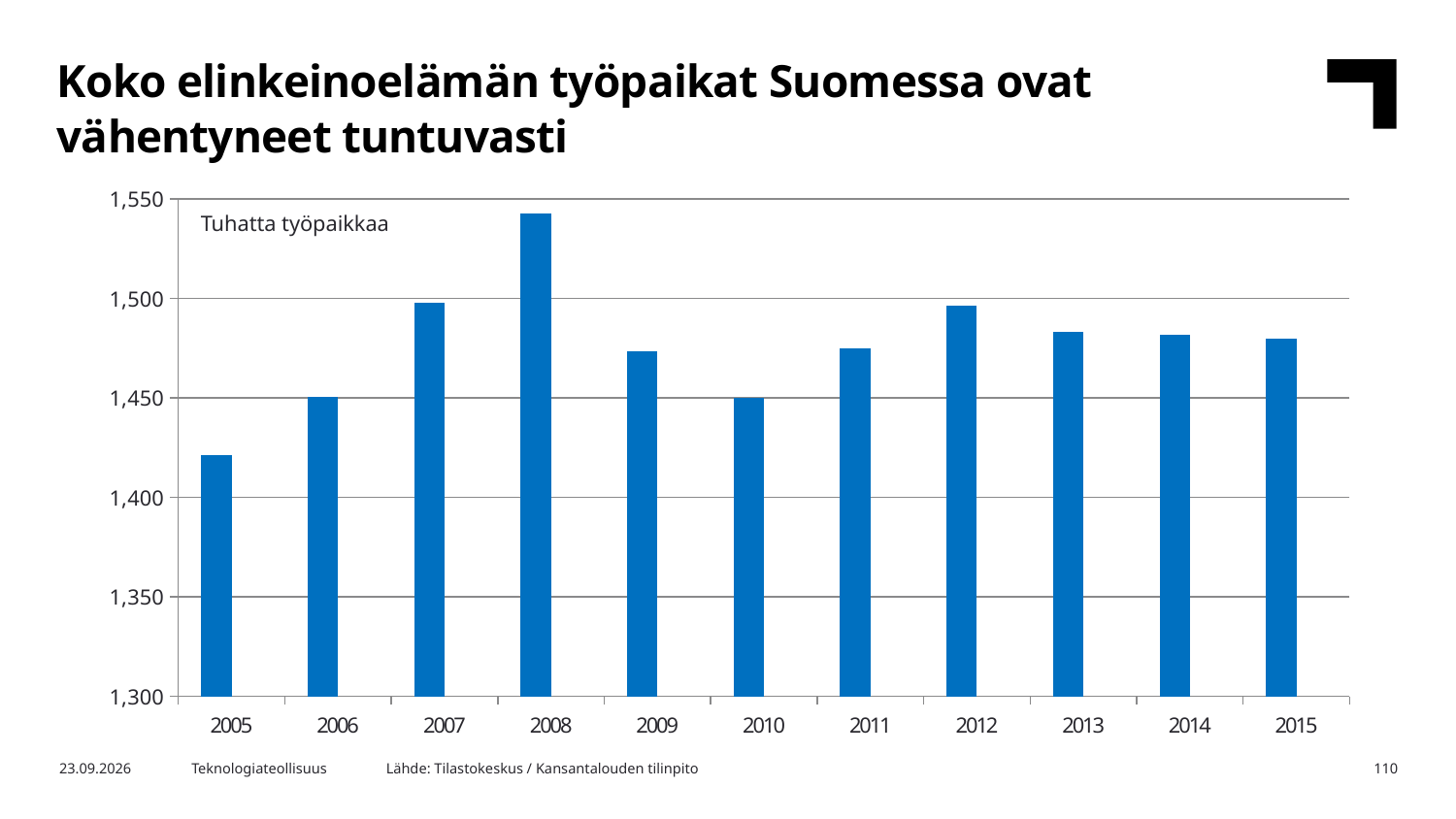
Which year has a higher value, 2007 or 2009? 2007 Is the value for 2013 greater or less than 1,500? less Which year has a higher value, 2005 or 2006? 2006 Is the value for 2005 greater or less than 1,450? less How many years are shown on the x axis of the chart? 11 Is the value for 2009 greater or less than 1,450? greater What type of chart is shown on the slide? Bar chart What unit label is shown inside the chart area? Tuhatta työpaikkaa Which year has the lowest number of jobs in the chart? 2005 Do the values rise or fall from 2012 to 2015? fall Which year has the highest number of jobs in the chart? 2008